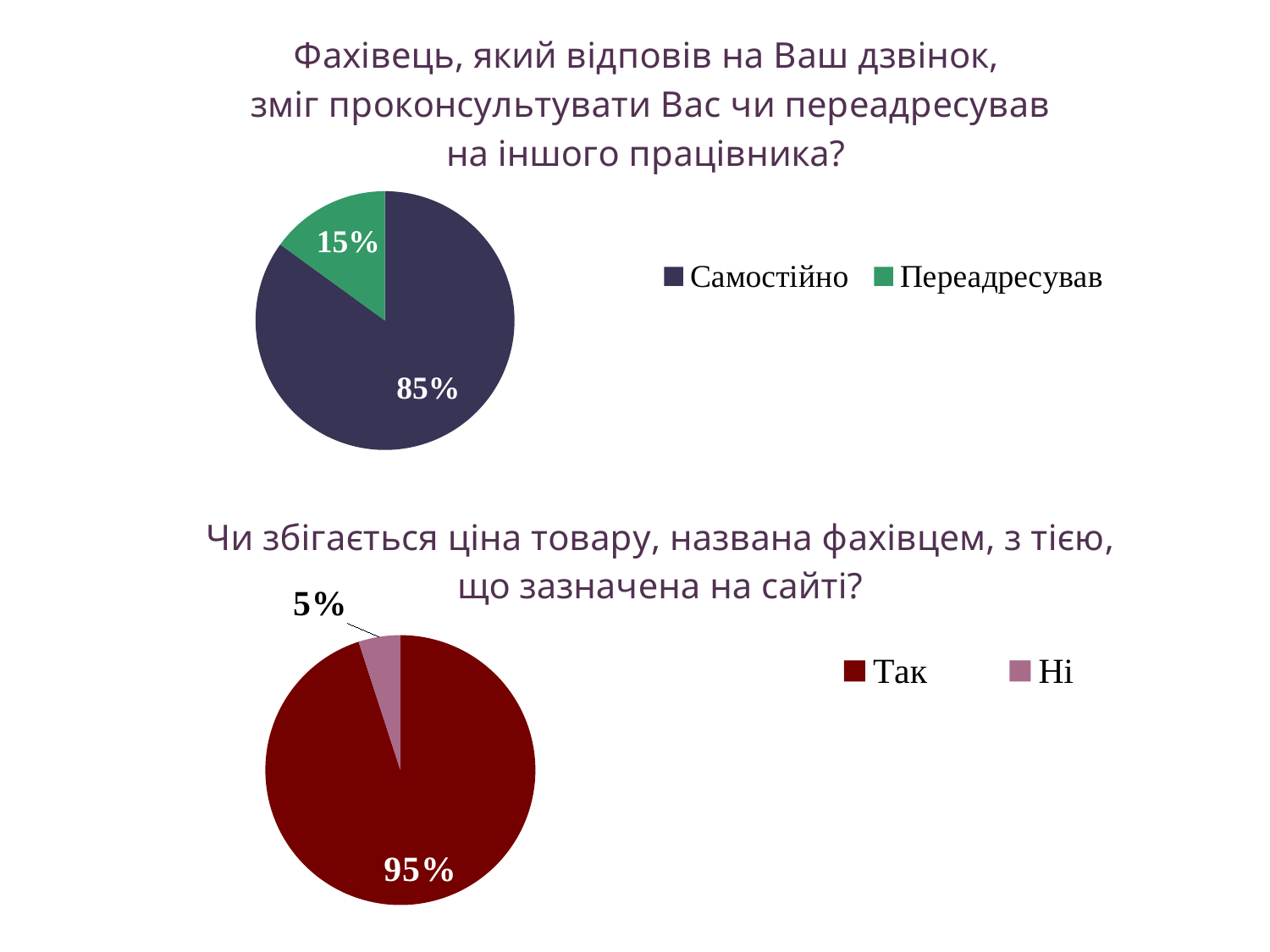
In the bottom chart, what colour is the "Так" slice? Dark red In the top chart, how many categories does the legend list? 2 In the bottom chart, which is larger, "Так" or "Ні"? Так In the top chart, which category has the largest slice? Самостійно What type of chart is the top chart? Pie chart In the bottom chart, which category has the smallest slice? Ні In the bottom chart, what is the difference in percentage points between "Так" and "Ні"? 90 In the top chart, what is the difference in percentage points between "Самостійно" and "Переадресував"? 70 In the top chart, what share of respondents answered "Переадресував"? 15% In the top chart, what share of respondents answered "Самостійно"? 85% In the bottom chart, what share of respondents answered "Ні"? 5% In the bottom chart, what share of respondents answered "Так"? 95%